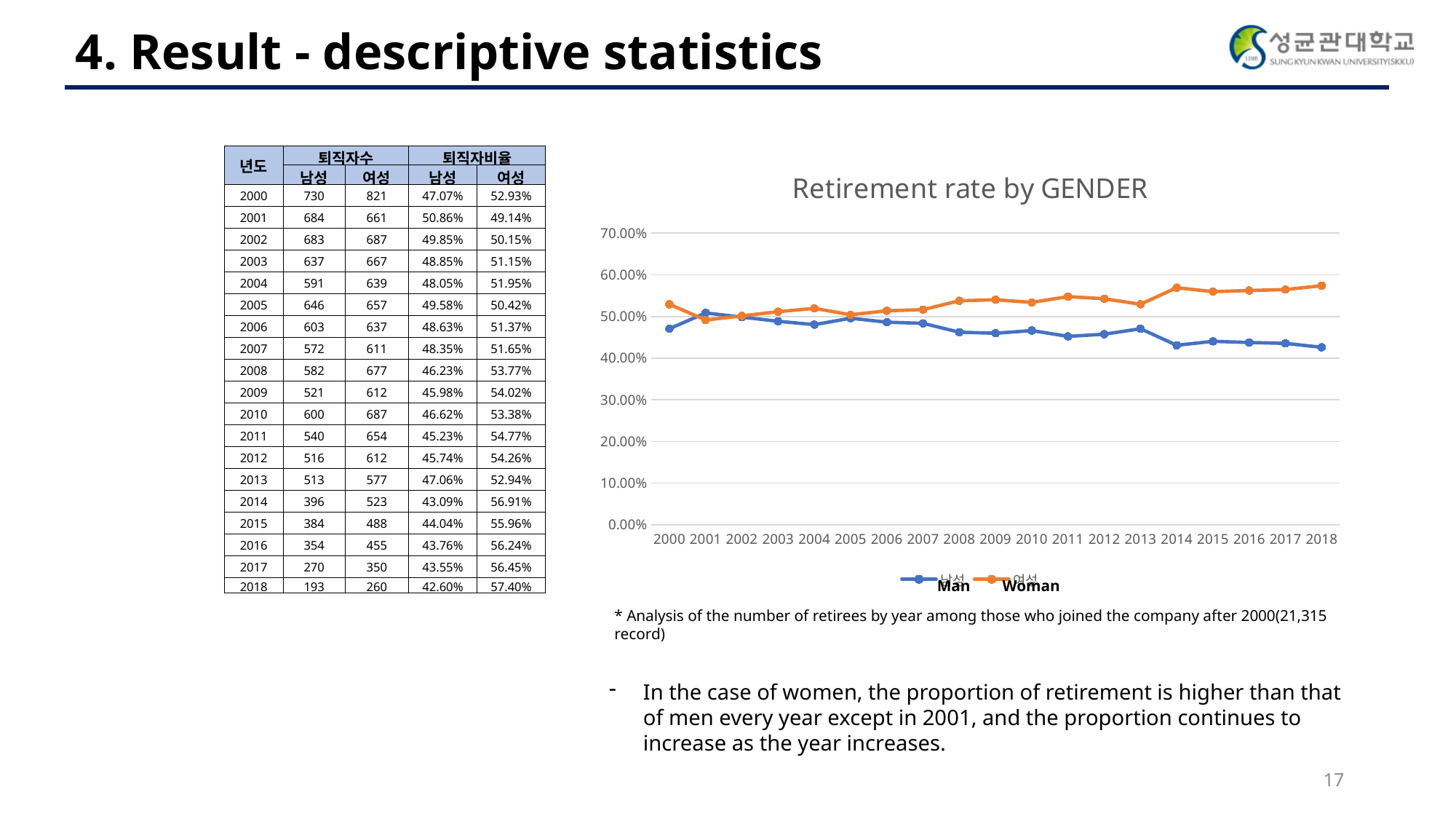
In the 'Retirement rate by GENDER' chart, does the Woman series generally rise or fall from 2000 to 2018? Rise In the 'Retirement rate by GENDER' chart, is the value for Man in 2018 greater or less than 50.00%? less How many years are plotted along the x axis of the 'Retirement rate by GENDER' chart? 19 In the 'Retirement rate by GENDER' chart, which series has the higher value in 2001, Man or Woman? Man How many series does the legend of the 'Retirement rate by GENDER' chart list? 2 According to the slide, what is the retirement rate for men in 2000? 47.07% In the 'Retirement rate by GENDER' chart, which series has the higher value in 2018, Man or Woman? Woman According to the slide, what is the retirement rate for women in 2018? 57.40% In the 'Retirement rate by GENDER' chart, is the value for Woman in 2014 greater or less than 50.00%? greater What kind of chart is 'Retirement rate by GENDER'? Line chart In the 'Retirement rate by GENDER' chart, does the Man series generally rise or fall from 2000 to 2018? Fall What is the title of the line chart on the slide? Retirement rate by GENDER